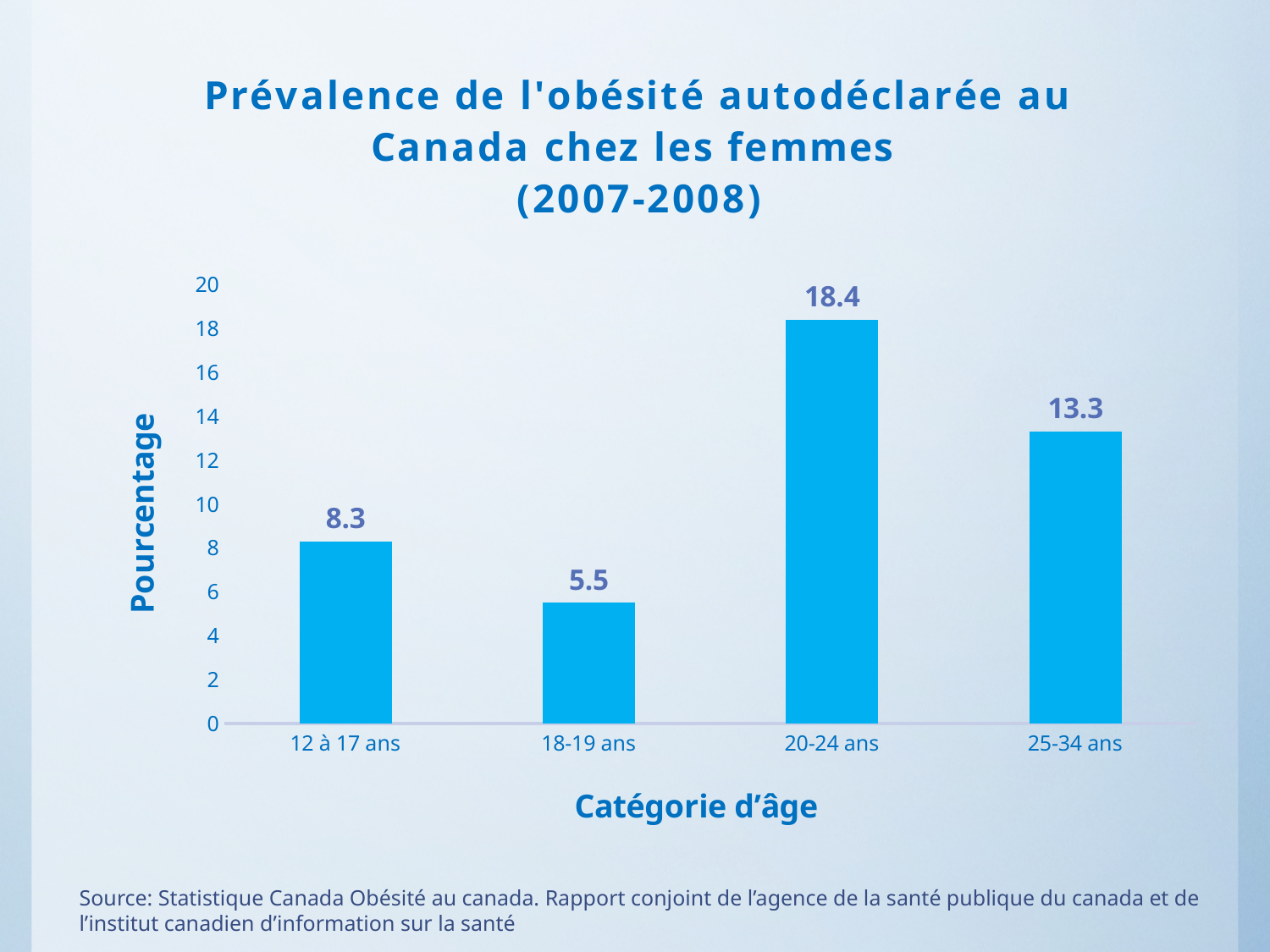
What is the difference between the values for 20-24 ans and 25-34 ans? 5.1 What is the value for the 12 à 17 ans age category? 8.3 Which age category has the lowest value? 18-19 ans How many age categories are shown on the chart? 4 What is the value for the 18-19 ans age category? 5.5 Is the value for 25-34 ans greater or less than 12? greater What is the value for the 20-24 ans age category? 18.4 What is the label of the horizontal axis? Catégorie d'âge What is the label of the vertical axis? Pourcentage What kind of chart is shown on the slide? bar chart Which age category has the highest value? 20-24 ans Which is larger, the value for 12 à 17 ans or the value for 18-19 ans? 12 à 17 ans